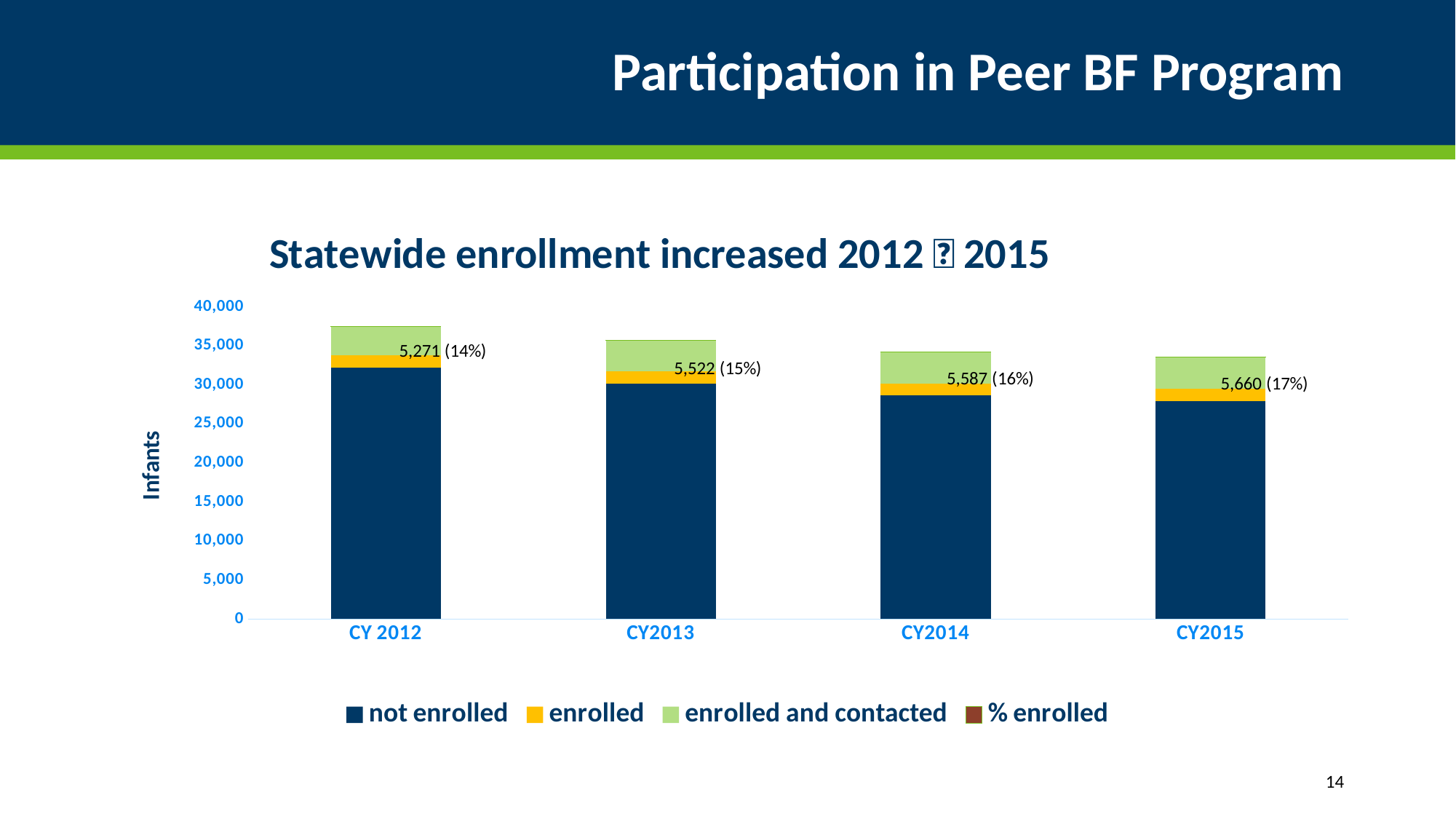
What is the label on the y axis? Infants Which labelled value is larger, CY2014 or CY2013? CY2014 How many categories (years) are shown on the x axis? 4 What is the difference between the labelled values for CY2015 (5,660) and CY 2012 (5,271)? 389 What data label is printed on the bar for CY2013? 5,522 (15%) Is the 'not enrolled' value for CY 2012 greater or less than 30,000? greater What kind of chart is shown on the slide? bar chart Is the total height of the CY2015 stacked bar greater or less than 35,000? less What data label is printed on the bar for CY2015? 5,660 (17%) How many series does the legend list? 4 What percentage is shown in the data label for CY 2012? 14% Which year has the tallest stacked bar overall? CY 2012